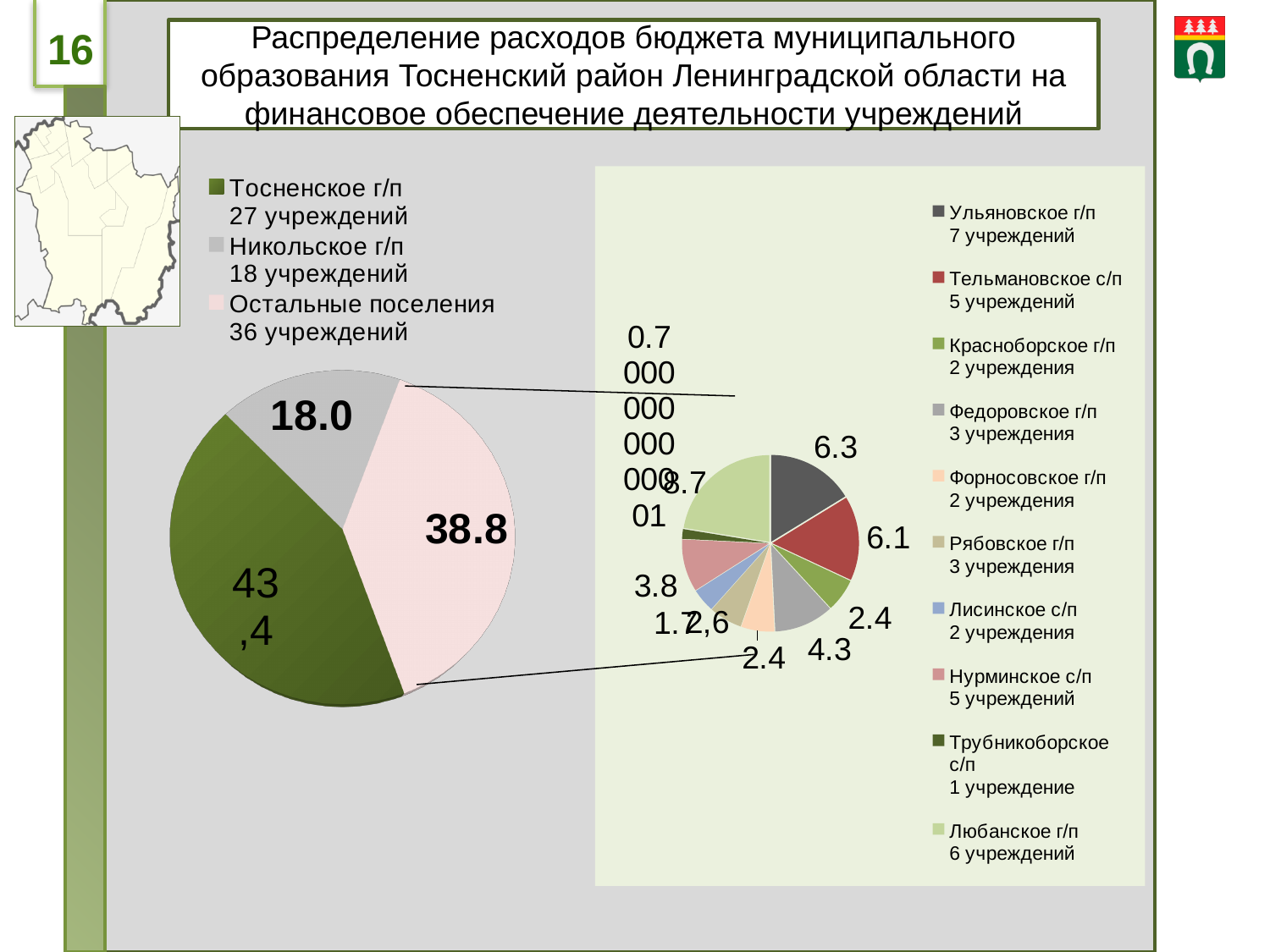
In the right pie chart, which is larger: the value for Ульяновское г/п or the value for Федоровское г/п? Ульяновское г/п In the left pie chart, what is the value shown for Никольское г/п? 18.0 In the left pie chart, what is the difference between the values for Остальные поселения and Никольское г/п? 20.8 How many entries does the legend of the left pie chart list? 3 In the right pie chart, what is the value shown for Тельмановское с/п? 6.1 How many entries does the legend of the right pie chart list? 10 In the left pie chart, what is the value shown for Остальные поселения? 38.8 In the left pie chart, which category has the smallest slice? Никольское г/п In the right pie chart, what is the value shown for Ульяновское г/п? 6.3 What kind of chart is the left chart on the slide? pie chart In the right pie chart, what is the value shown for Федоровское г/п? 4.3 In the left pie chart, which category has the largest slice? Тосненское г/п